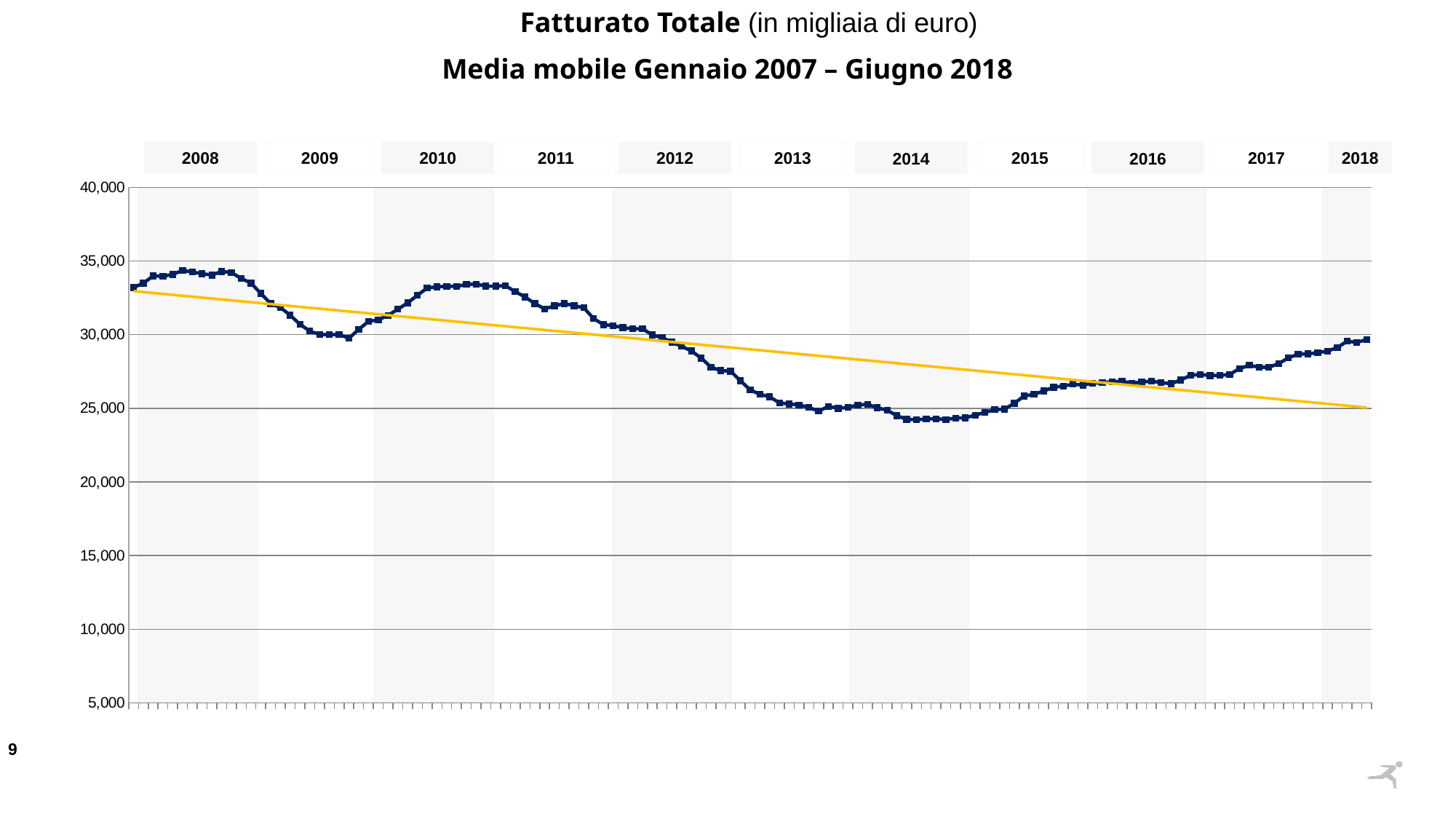
Does the moving average line rise or fall between 2014 and 2018? rise What kind of chart is shown on the slide? line chart Is the moving average value during 2016 greater or less than 30,000? less Is the moving average value during 2014 greater or less than 30,000? less How many year labels are shown along the top of the chart? 11 Is the moving average value in 2018 greater or less than 25,000? greater Does the moving average line rise or fall between 2010 and 2014? fall What is the highest value shown on the vertical axis? 40,000 What is the title of the chart? Fatturato Totale (in migliaia di euro) – Media mobile Gennaio 2007 – Giugno 2018 In which year does the moving average line reach its lowest values? 2014